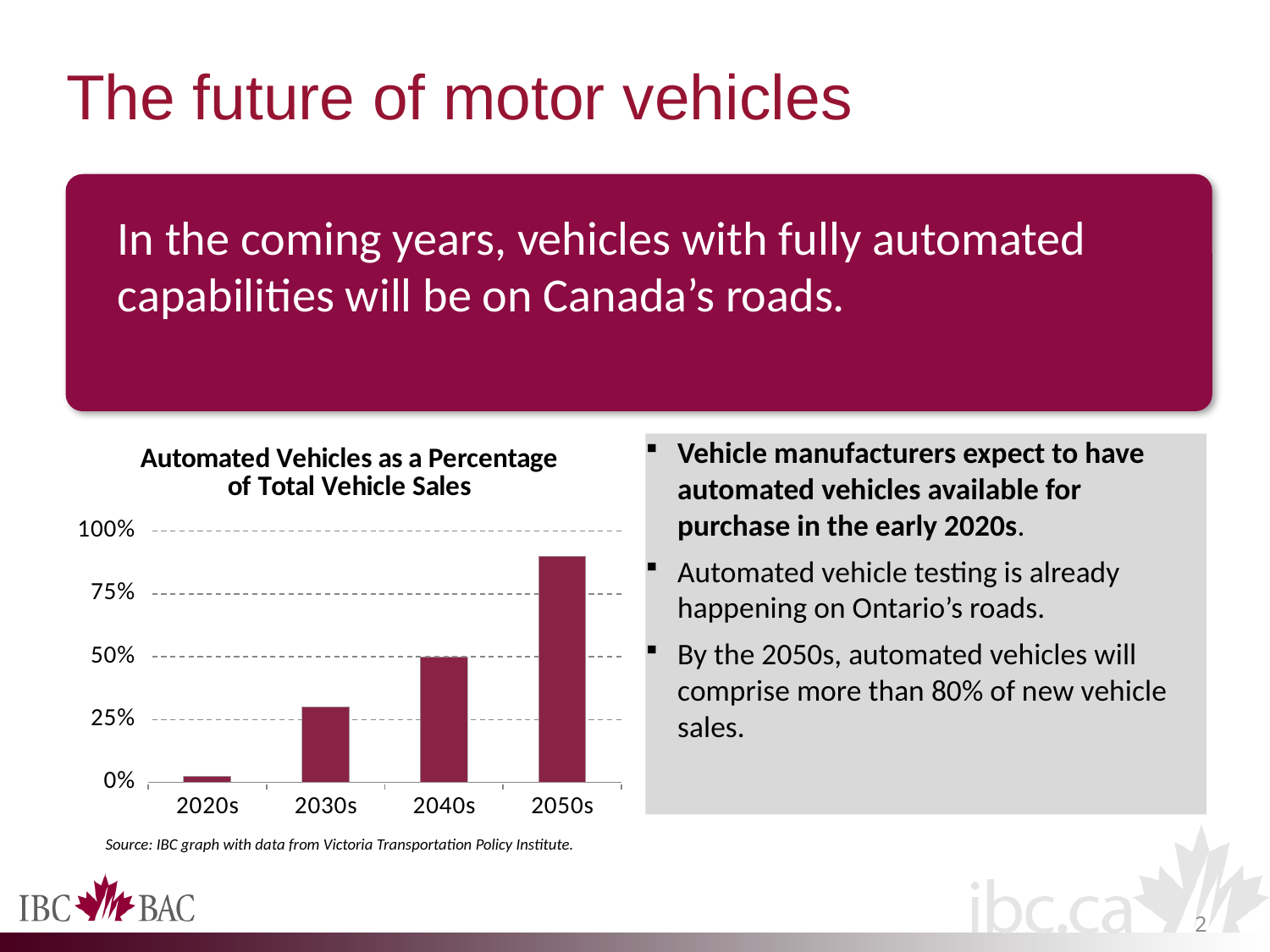
Which decade has the highest value in the chart? 2050s What is the highest value shown on the chart's y axis? 100% Do the values rise or fall from the 2020s to the 2050s? rise What is the title of the chart? Automated Vehicles as a Percentage of Total Vehicle Sales Is the value for the 2030s greater or less than 50%? less How many categories are shown on the x axis of the chart? 4 Which is larger, the value for the 2040s or the value for the 2030s? 2040s Is the value for the 2020s greater or less than 25%? less Is the value for the 2050s greater or less than 75%? greater Which decade has the lowest value in the chart? 2020s What kind of chart is shown on the slide? bar chart